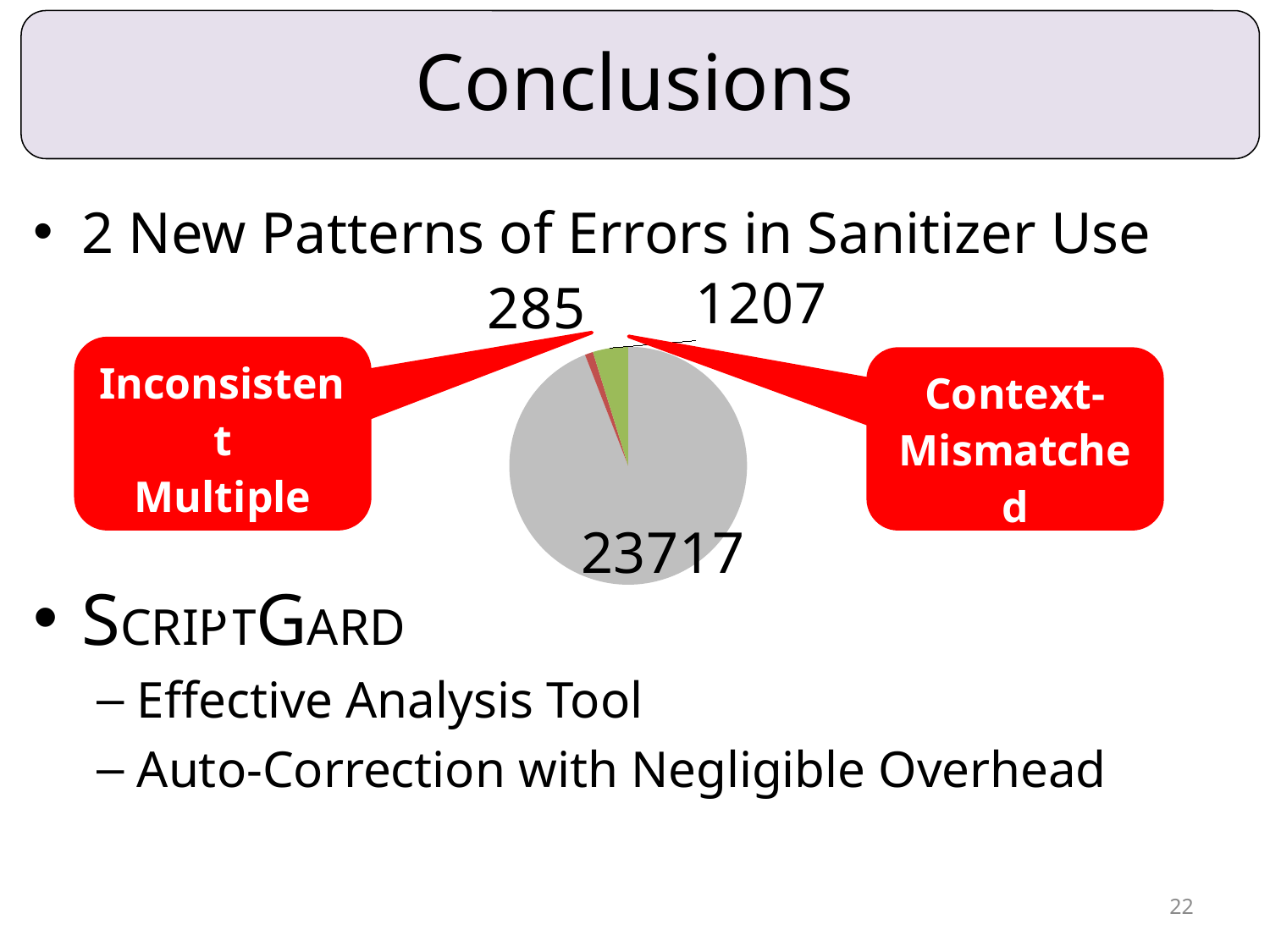
What colour is the largest slice of the pie chart? gray What is the smallest value shown on the pie chart? 285 What type of chart is shown on the slide? pie chart What is the total of the three values shown on the pie chart? 25209 What is the difference between the largest slice value (23717) and the Context-Mismatched value (1207)? 22510 What value is labelled for the Context-Mismatched slice of the pie chart? 1207 What is the difference between the Context-Mismatched value and the Inconsistent Multiple value? 922 Which is larger, the Context-Mismatched slice or the Inconsistent Multiple slice? Context-Mismatched How many slices does the pie chart have? 3 What is the largest value shown on the pie chart? 23717 What value is labelled on the large gray slice of the pie chart? 23717 What value is labelled for the Inconsistent Multiple slice of the pie chart? 285